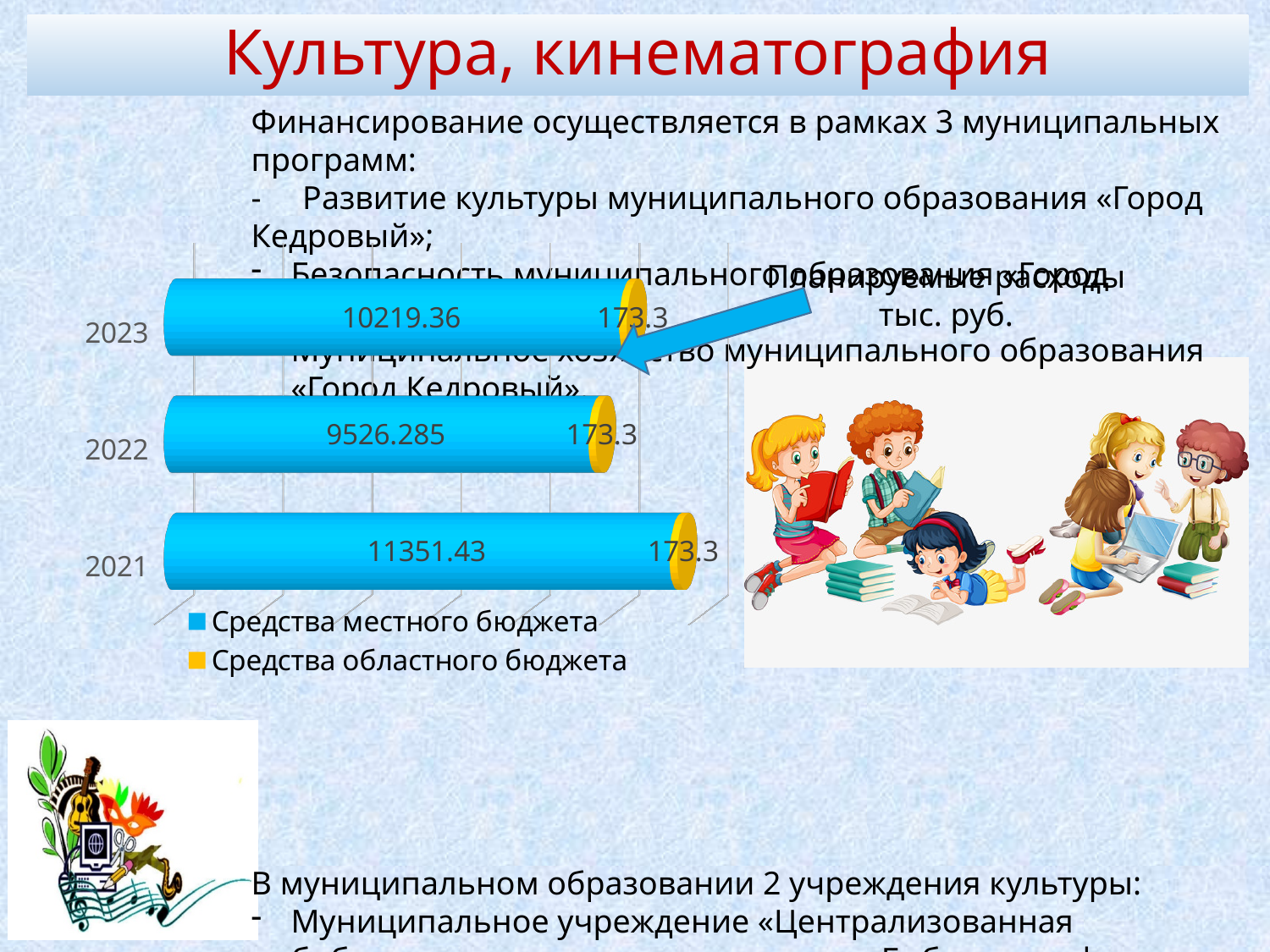
What type of chart is shown on the slide? bar chart How many years (categories) are shown in the chart? 3 What is the value of 'Средства местного бюджета' for 2021? 11351.43 Which year has the highest value for 'Средства местного бюджета'? 2021 What is the total of the stacked bar for 2021? 11524.73 Which legend entry is shown in blue? Средства местного бюджета What is the value of 'Средства областного бюджета' for 2022? 173.3 How many series does the chart legend list? 2 What is the value of 'Средства местного бюджета' for 2023? 10219.36 Which is larger, the 'Средства местного бюджета' value for 2023 or for 2022? 2023 Which year has the lowest value for 'Средства местного бюджета'? 2022 What is the value of 'Средства местного бюджета' for 2022? 9526.285